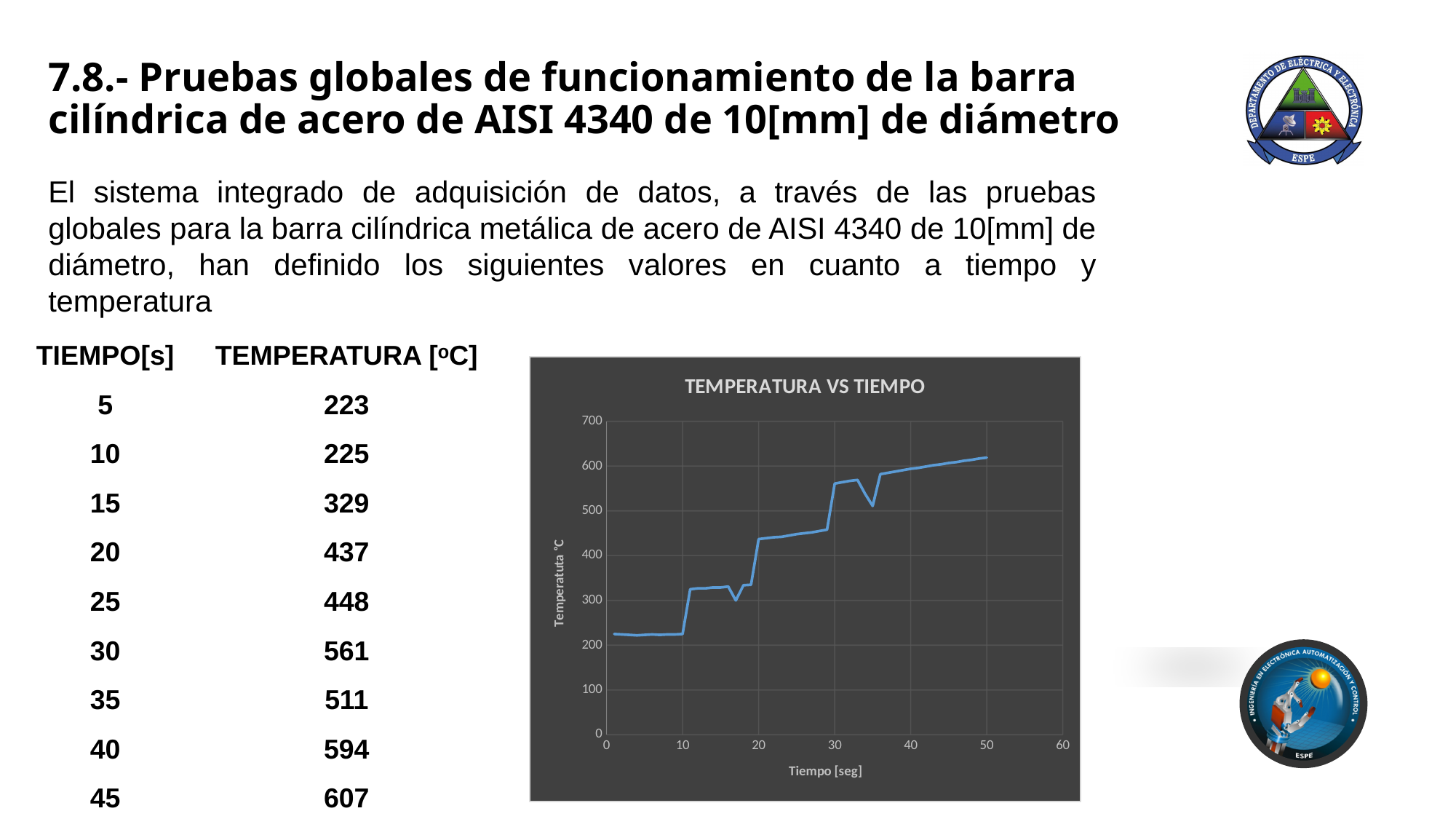
Is the temperature at 10 seconds greater or less than 300? less Is the temperature at 40 seconds greater or less than 500? greater What kind of chart is shown on the slide? line chart Which is lower on the chart, the temperature at 20 seconds or at 50 seconds? 20 seconds Overall, does the temperature rise or fall as time increases along the x axis? rise Which is higher on the chart, the temperature at 10 seconds or at 40 seconds? 40 seconds Is the temperature at 20 seconds greater or less than 400? greater What is the title of the chart? TEMPERATURA VS TIEMPO What is the label of the x axis of the chart? Tiempo [seg]